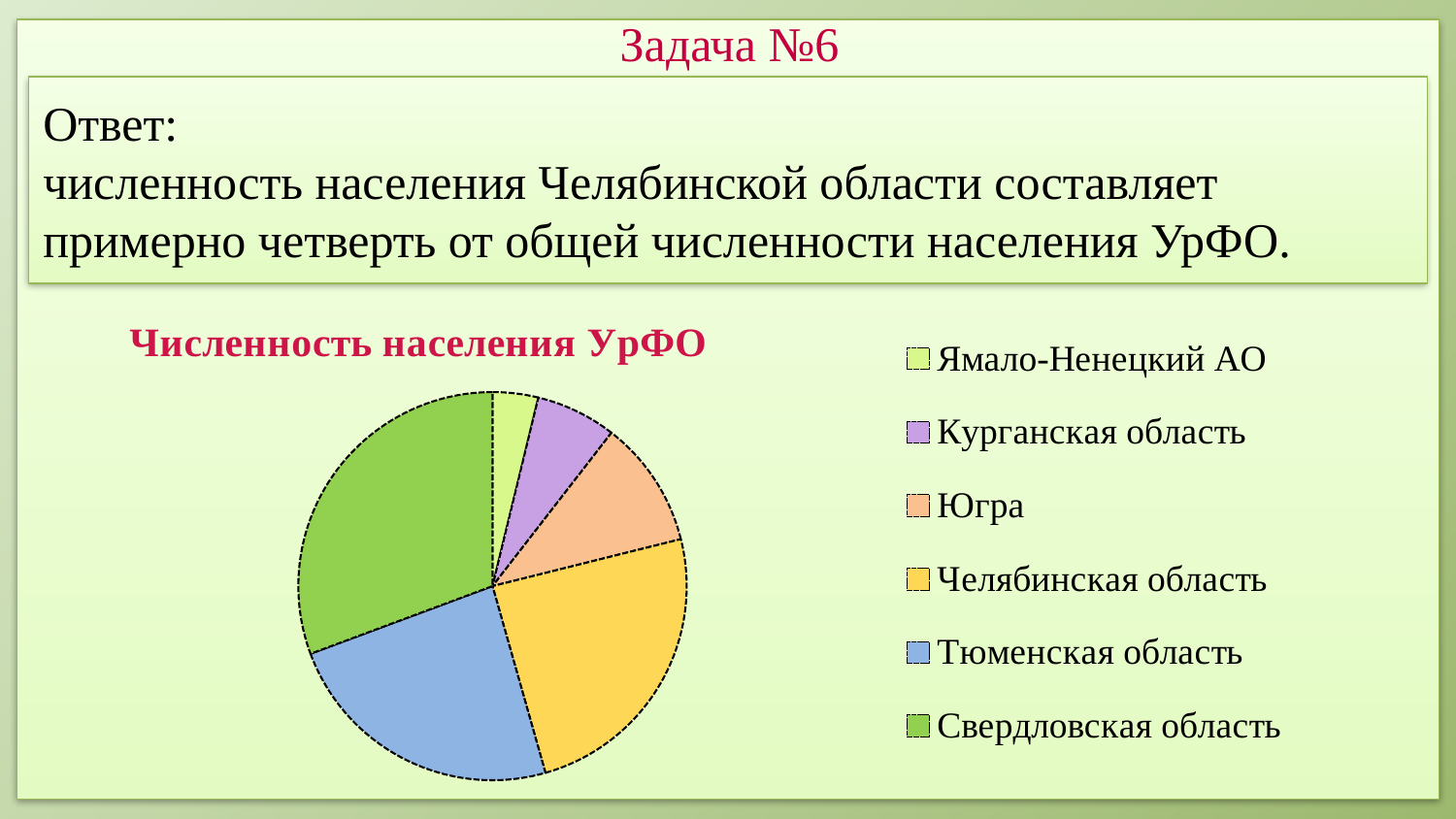
How many categories does the pie chart have? 6 Which slice is larger: Челябинская область or Курганская область? Челябинская область Which slice is larger: Свердловская область or Челябинская область? Свердловская область Which slice is larger: Тюменская область or Югра? Тюменская область What kind of chart is shown on the slide? pie chart Which region has the largest slice of the pie? Свердловская область Which region has the smallest slice of the pie? Ямало-Ненецкий АО Which colour represents Челябинская область in the pie chart? yellow What is the title of the chart? Численность населения УрФО